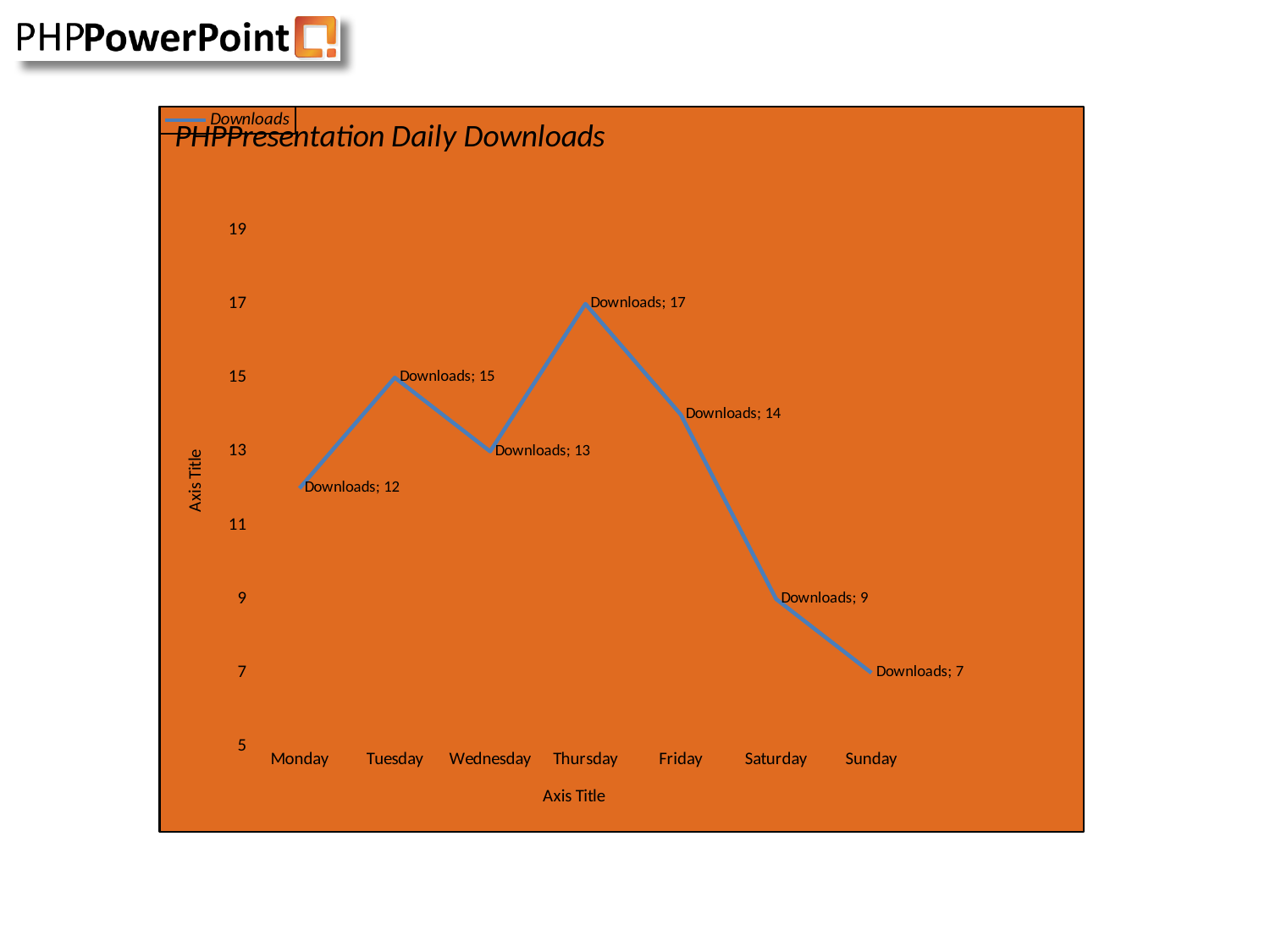
Which is larger, the value for Tuesday or the value for Friday? Tuesday Which day has the lowest number of downloads? Sunday How many series does the legend list? 1 What kind of chart is shown? line chart How many days are plotted on the x axis? 7 Is the value for Saturday greater or less than 11? less What is the value for Sunday? 7 What is the title of the chart? PHPPresentation Daily Downloads What is the value for Monday? 12 What is the difference between the values for Thursday and Sunday? 10 What is the value for Thursday? 17 Which day has the highest number of downloads? Thursday